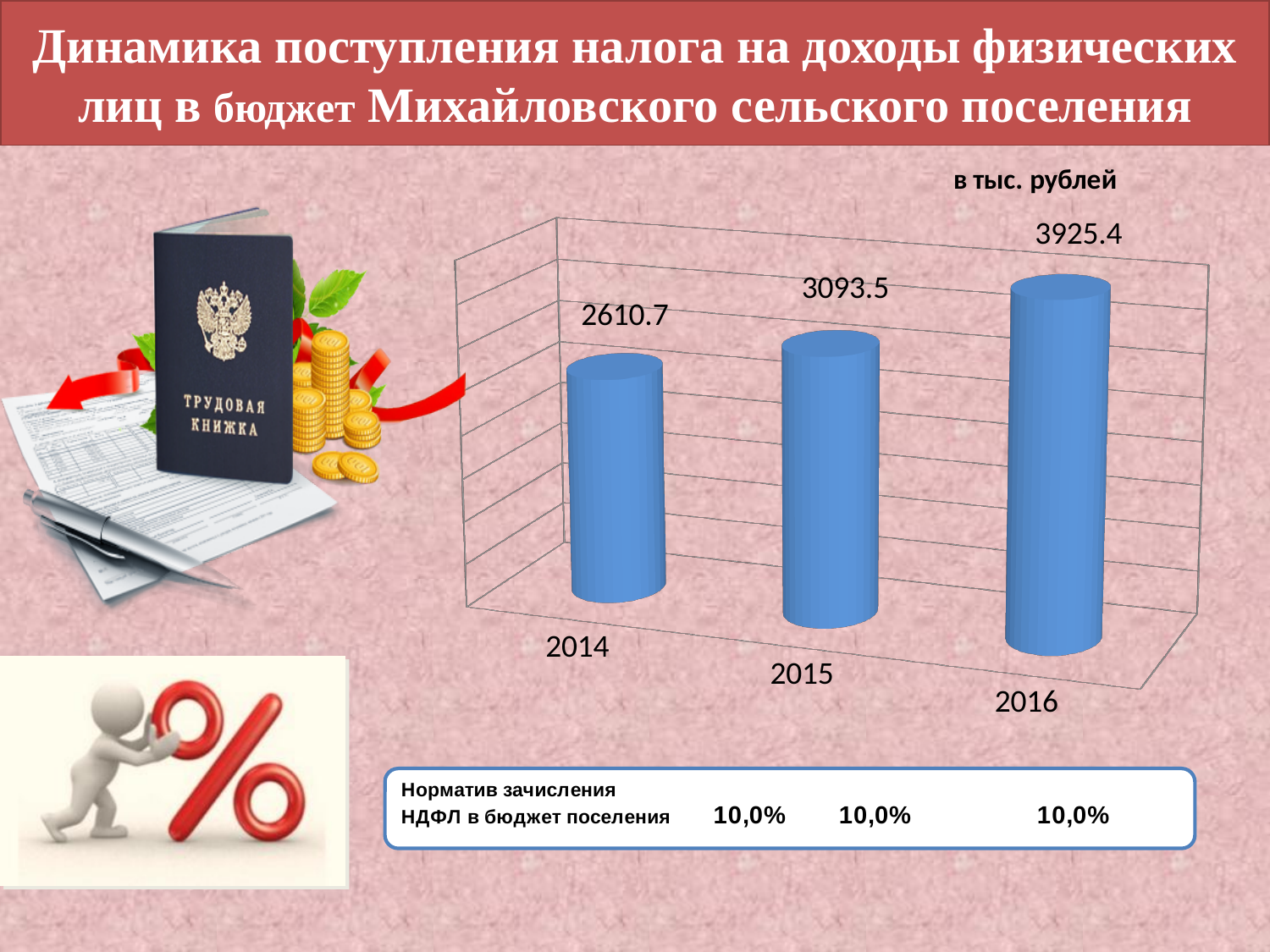
What is the value for 2014 on the chart? 2610.7 Which year has the lowest value on the chart? 2014 What is the difference between the values for 2016 and 2014? 1314.7 What is the difference between the values for 2016 and 2015? 831.9 Which is larger, the value for 2015 or the value for 2016? 2016 How many years are shown on the chart? 3 What is the difference between the values for 2015 and 2014? 482.8 What kind of chart is shown on the slide? bar chart Do the values rise or fall from 2014 to 2016? rise What is the value for 2016 on the chart? 3925.4 Which year has the highest value on the chart? 2016 What is the value for 2015 on the chart? 3093.5